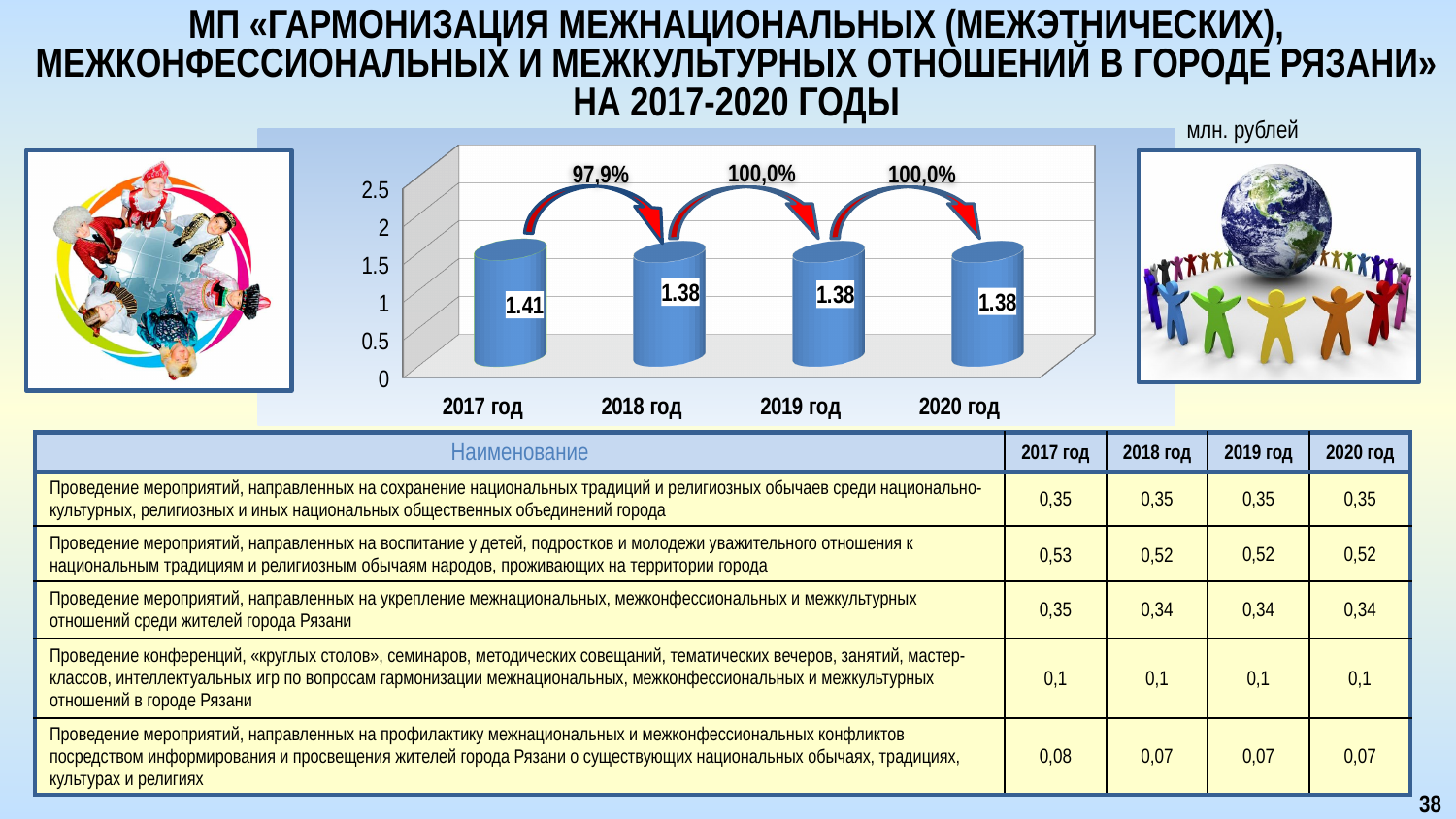
What is the value for 2017 год on the chart? 1.41 What is the value for 2020 год on the chart? 1.38 What kind of chart is shown on the slide? bar chart What is the difference between the values for 2017 год and 2018 год? 0.03 Which year has the highest value on the chart? 2017 год Do the values on the chart rise or fall from 2017 год to 2018 год? fall How many years are shown on the x axis of the chart? 4 What is the value for 2019 год on the chart? 1.38 What percentage is shown on the arrow between 2017 год and 2018 год? 97,9% Which is larger, the value for 2017 год or the value for 2020 год? 2017 год Is the value for 2018 год greater or less than 2? less What unit is indicated for the chart values? млн. рублей